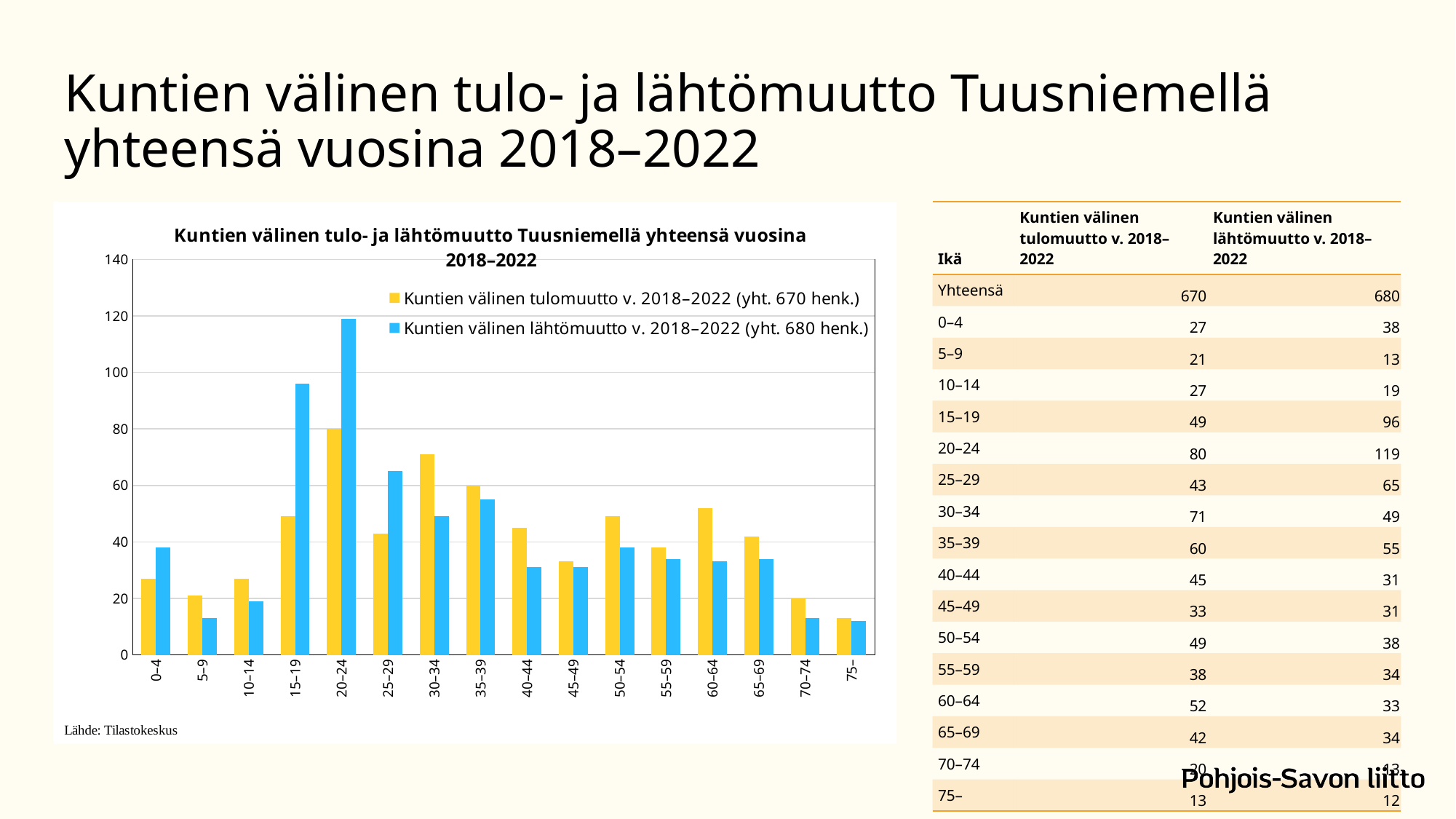
Which age group has the highest value for Kuntien välinen tulomuutto v. 2018–2022? 20–24 How many series does the chart legend list? 2 What is the difference between lähtömuutto and tulomuutto for the 20–24 age group? 39 Which colour represents Kuntien välinen lähtömuutto v. 2018–2022 in the chart? blue Which age group has the highest value for Kuntien välinen lähtömuutto v. 2018–2022? 20–24 What kind of chart is shown on the slide? bar chart According to the legend, what is the total number of persons for Kuntien välinen tulomuutto v. 2018–2022? 670 henk. Is the value of Kuntien välinen lähtömuutto v. 2018–2022 for the 20–24 age group greater or less than 100? greater What is the value of Kuntien välinen tulomuutto v. 2018–2022 for the 30–34 age group? 71 For the 60–64 age group, which is larger: tulomuutto or lähtömuutto? tulomuutto What is the value of Kuntien välinen lähtömuutto v. 2018–2022 for the 15–19 age group? 96 How many age groups are shown on the x axis of the chart? 16